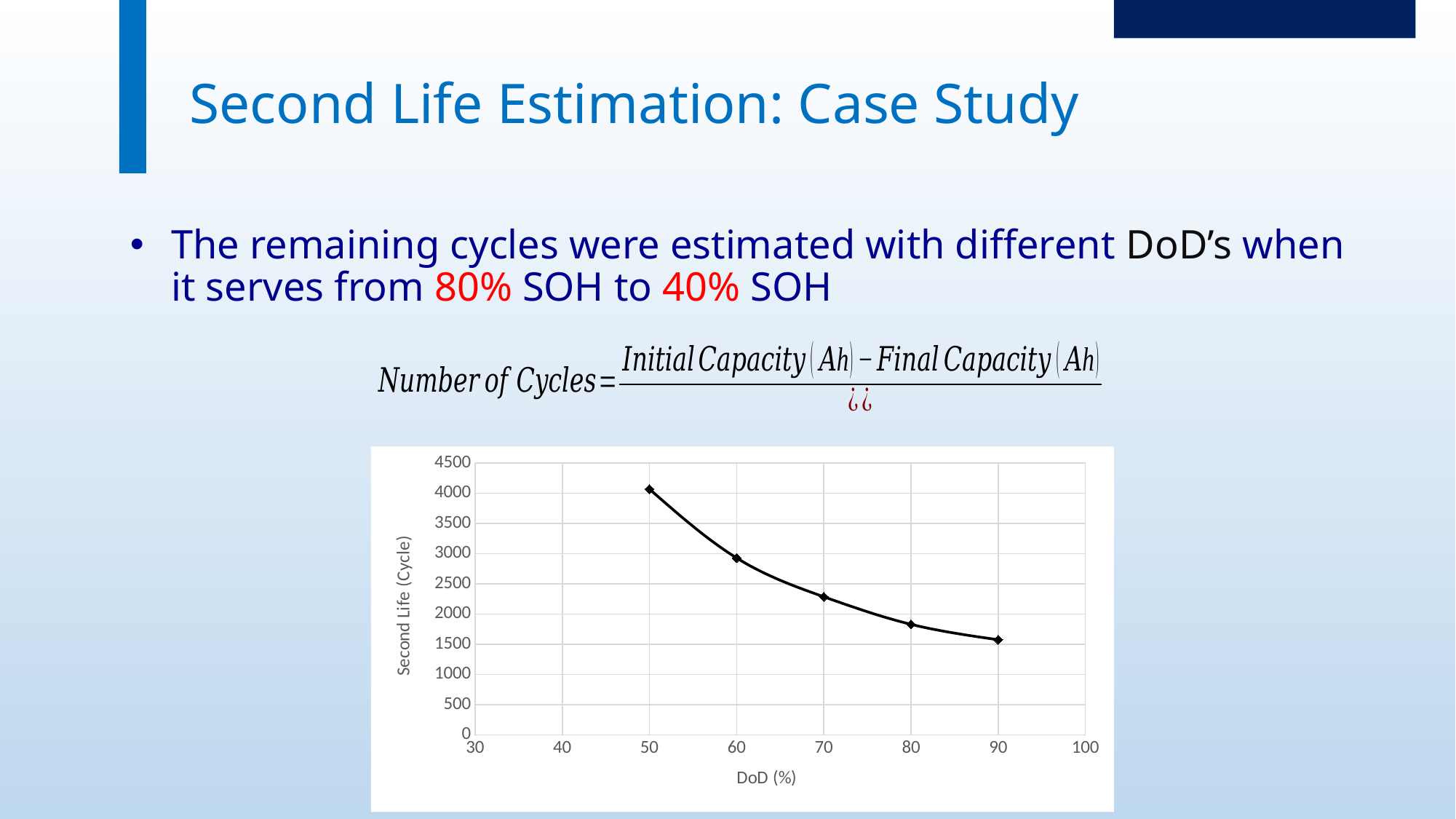
Do the Second Life values rise or fall as DoD increases along the x axis? fall At which DoD (%) is the Second Life (Cycle) value highest? 50 Is the Second Life value at DoD 80% greater or less than 2000? less What is the label of the vertical axis of the chart? Second Life (Cycle) At which DoD (%) is the Second Life (Cycle) value lowest? 90 Which has a larger Second Life value: DoD 60% or DoD 80%? DoD 60% Is the Second Life value at DoD 50% greater or less than 3500? greater What kind of chart is shown on the slide? line chart How many data points are plotted on the chart? 5 Is the Second Life value at DoD 90% greater or less than 2000? less